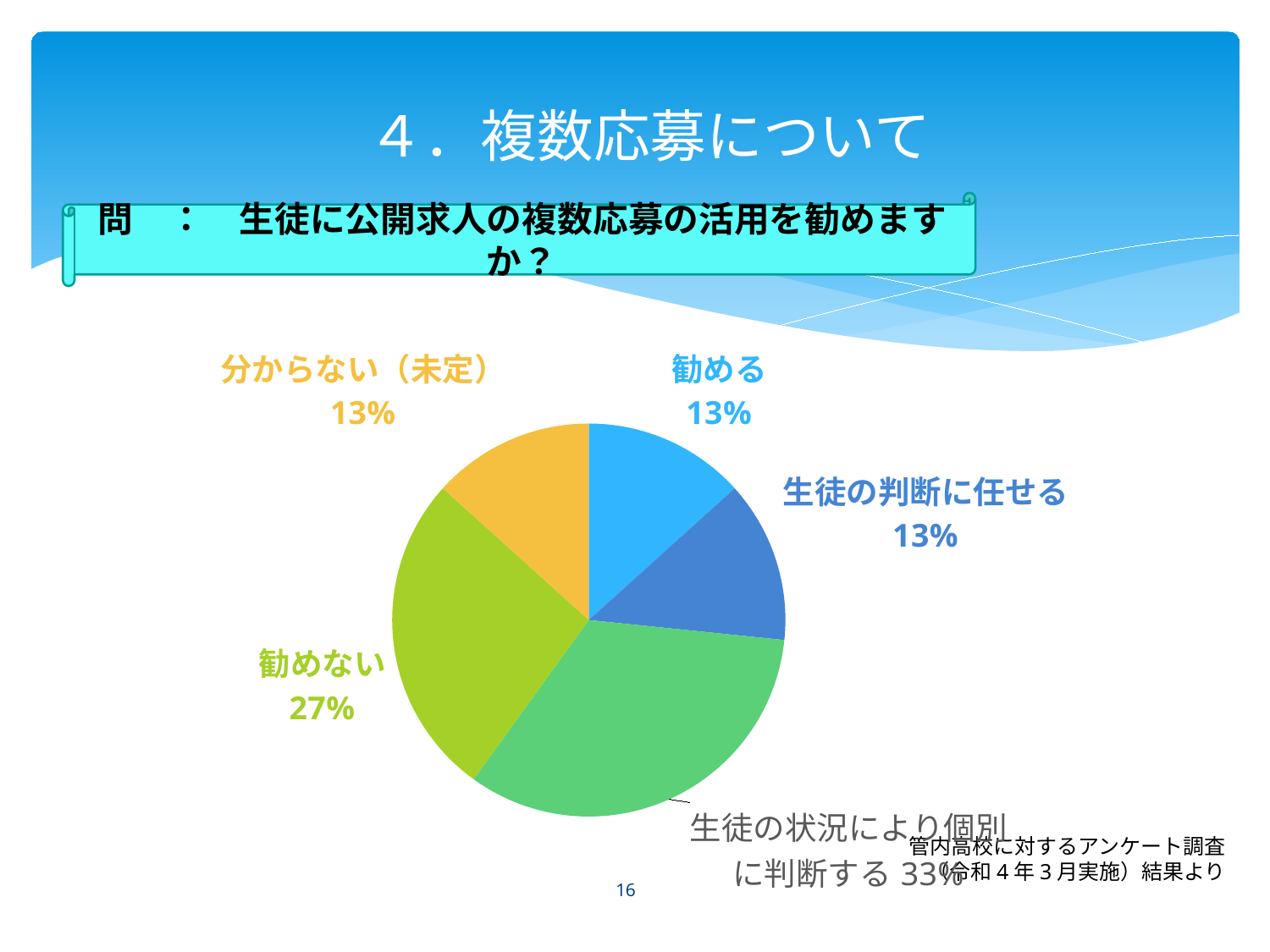
Which is larger, 勧めない or 勧める? 勧めない What kind of chart is shown on the slide? pie chart What is the difference between the shares of 生徒の状況により個別に判断する and 勧めない? 6% What percentage of the pie is 勧めない? 27% How many slices does the pie chart have? 5 Which category has the largest share of the pie? 生徒の状況により個別に判断する What percentage of the pie is 勧める? 13% What percentage of the pie is 生徒の判断に任せる? 13% What percentage of the pie is 生徒の状況により個別に判断する? 33% What is the difference between the shares of 勧めない and 分からない（未定）? 14% What colour is the 勧めない slice? green (yellow-green) What percentage of the pie is 分からない（未定）? 13%